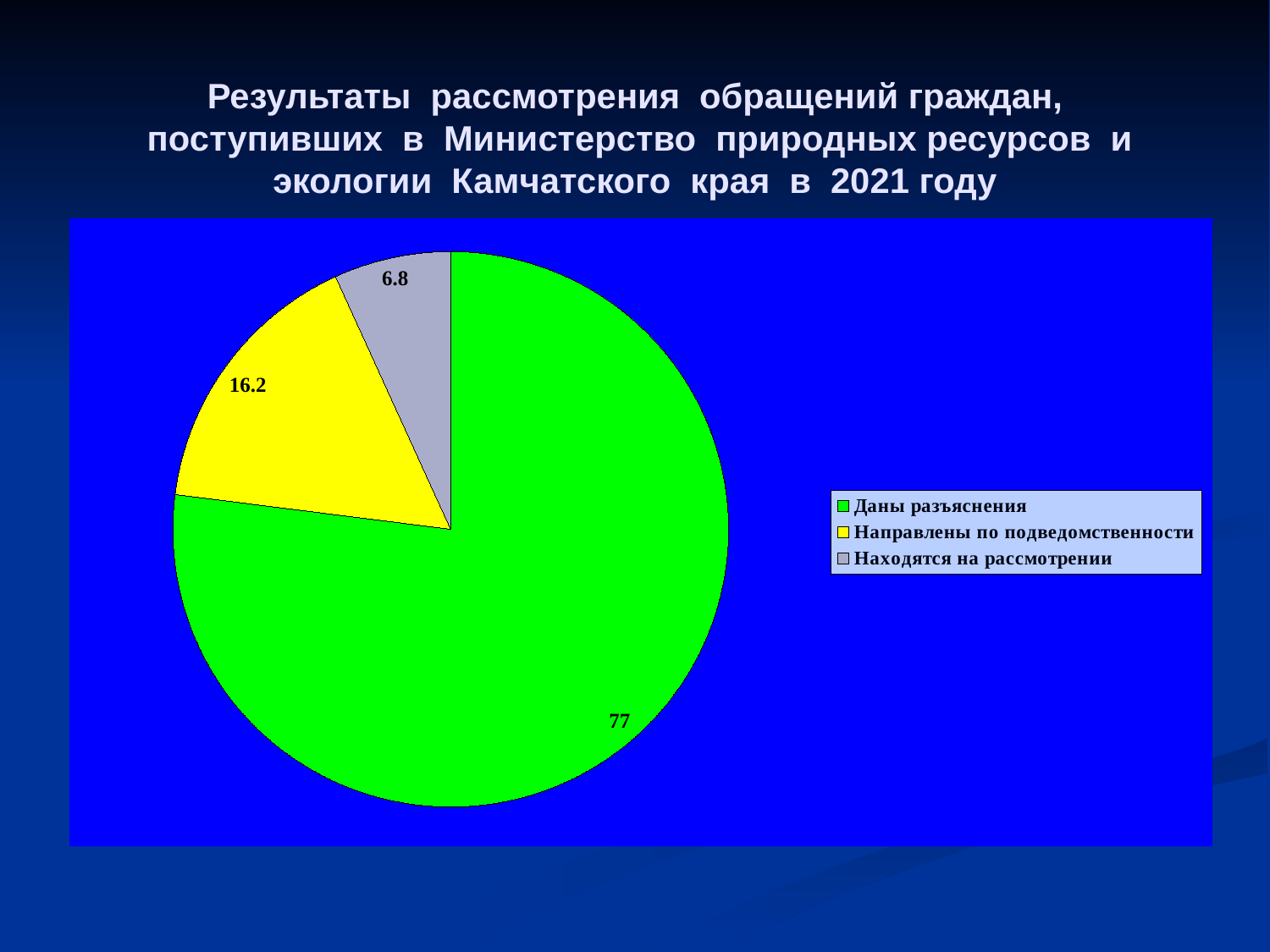
How many slices does the pie chart have? 3 Which category has the smallest slice of the pie? Находятся на рассмотрении What colour is the slice for "Направлены по подведомственности"? Yellow What value is shown for the slice "Направлены по подведомственности"? 16.2 What is the difference between the values for "Даны разъяснения" and "Направлены по подведомственности"? 60.8 What kind of chart is shown on the slide? Pie chart What is the difference between the values for "Направлены по подведомственности" and "Находятся на рассмотрении"? 9.4 What value is shown for the slice "Даны разъяснения"? 77 How many entries does the legend list? 3 What value is shown for the slice "Находятся на рассмотрении"? 6.8 Which is larger: the slice for "Направлены по подведомственности" or the slice for "Находятся на рассмотрении"? Направлены по подведомственности Which category has the largest slice of the pie? Даны разъяснения